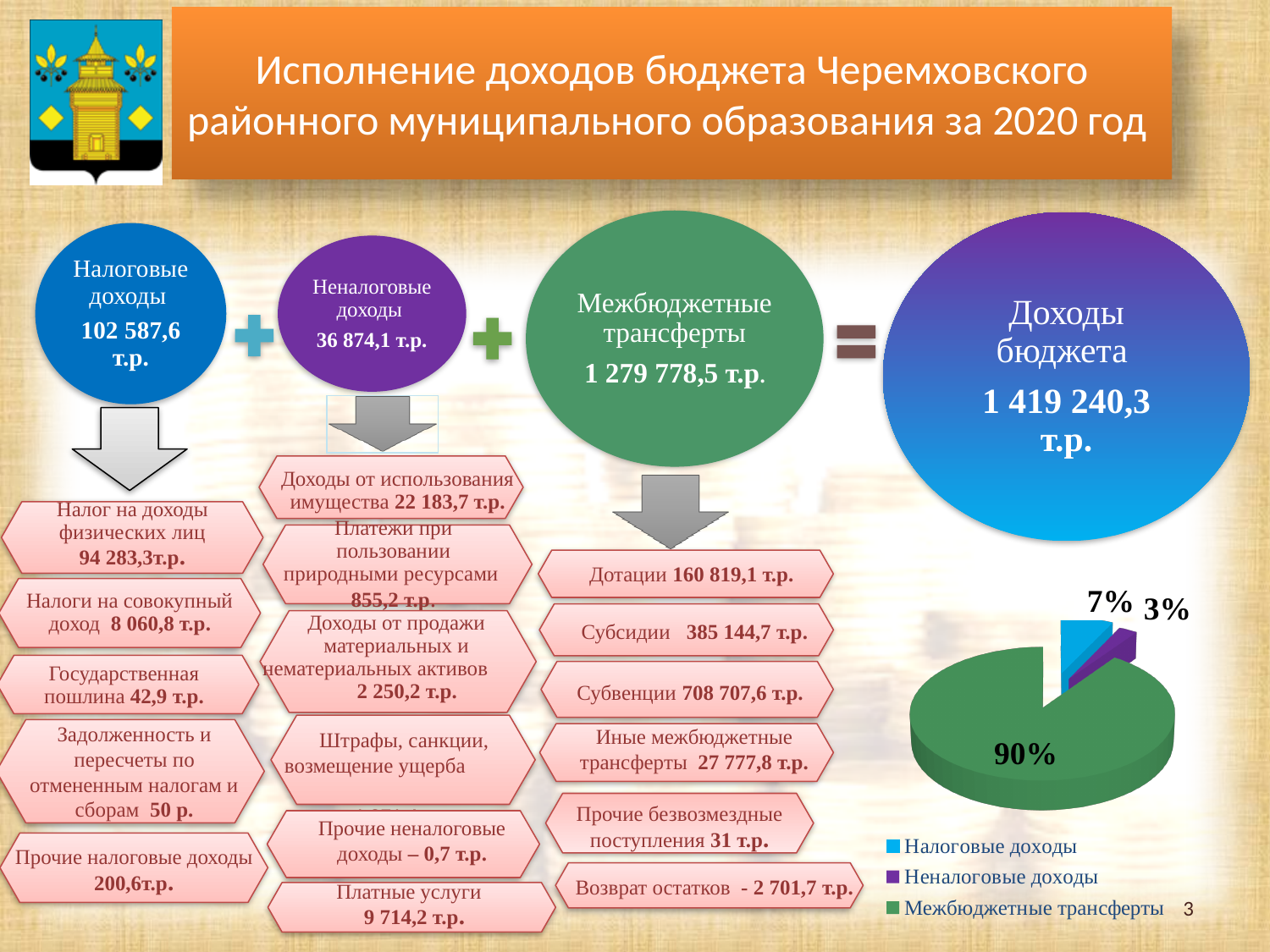
What colour is the Межбюджетные трансферты slice in the pie chart? Green Which category has the smallest slice in the pie chart? Неналоговые доходы In the pie chart, what share is shown for Неналоговые доходы? 3% In the pie chart, what share is shown for Межбюджетные трансферты? 90% In the pie chart, by how many percentage points does the share of Налоговые доходы exceed the share of Неналоговые доходы? 4 percentage points In the pie chart, which is larger: the share of Налоговые доходы or the share of Неналоговые доходы? Налоговые доходы How many entries does the pie chart's legend list? 3 In the pie chart, by how many percentage points does the share of Межбюджетные трансферты exceed the share of Налоговые доходы? 83 percentage points Which category has the largest slice in the pie chart? Межбюджетные трансферты In the pie chart, what share is shown for Налоговые доходы? 7% How many slices does the pie chart have? 3 What kind of chart is shown on the slide? Pie chart